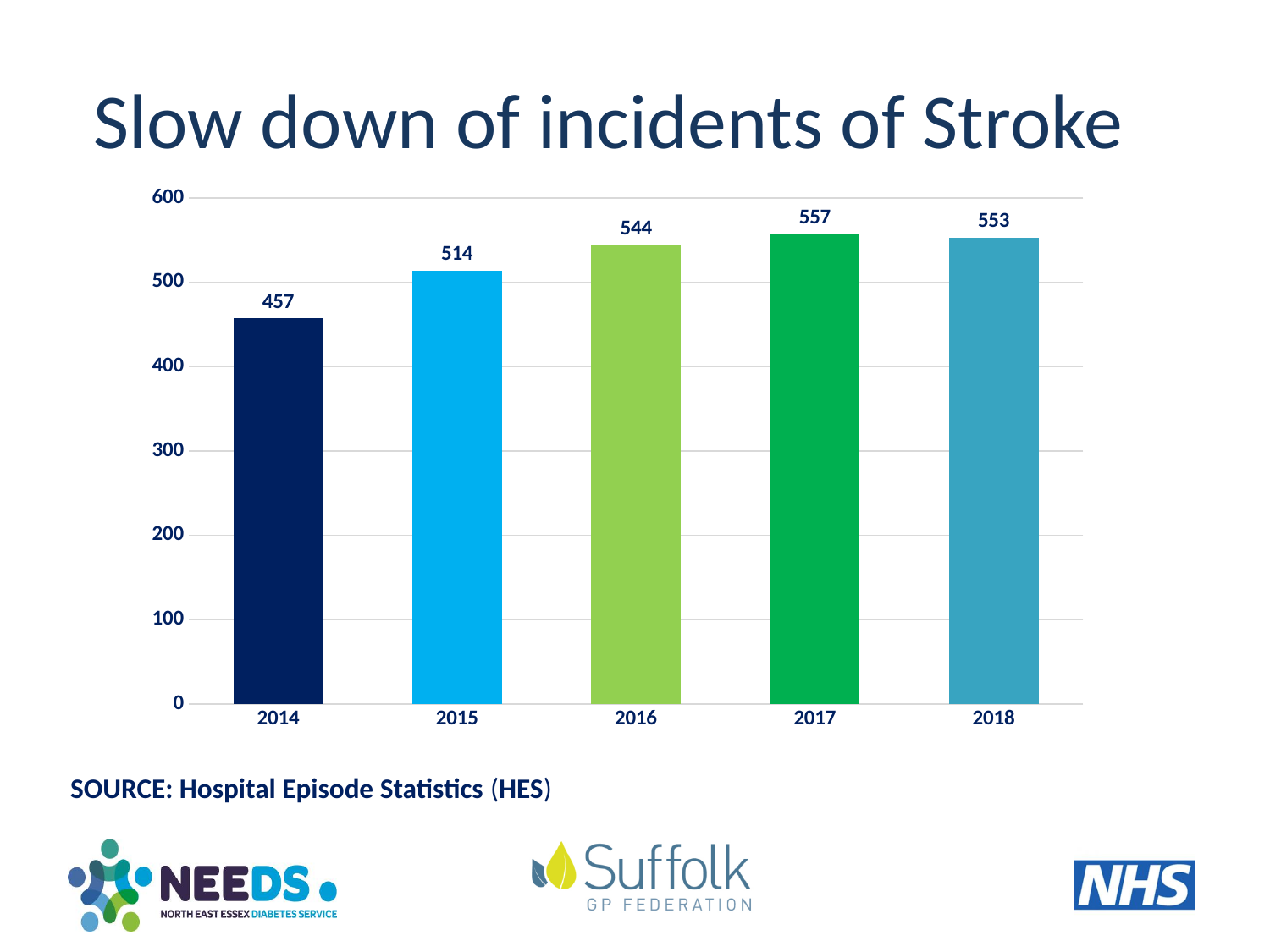
Which is larger, the value for 2016 or the value for 2015? 2016 Is the value for 2014 greater or less than 500? less What is the difference between the values for 2015 and 2014? 57 Which year has the highest value? 2017 What is the title of the slide? Slow down of incidents of Stroke What is the value for 2018? 553 What kind of chart is shown on the slide? bar chart What is the difference between the values for 2017 and 2018? 4 What is the value for 2017? 557 How many years are shown on the x axis? 5 Which year has the lowest value? 2014 What is the value for 2014? 457